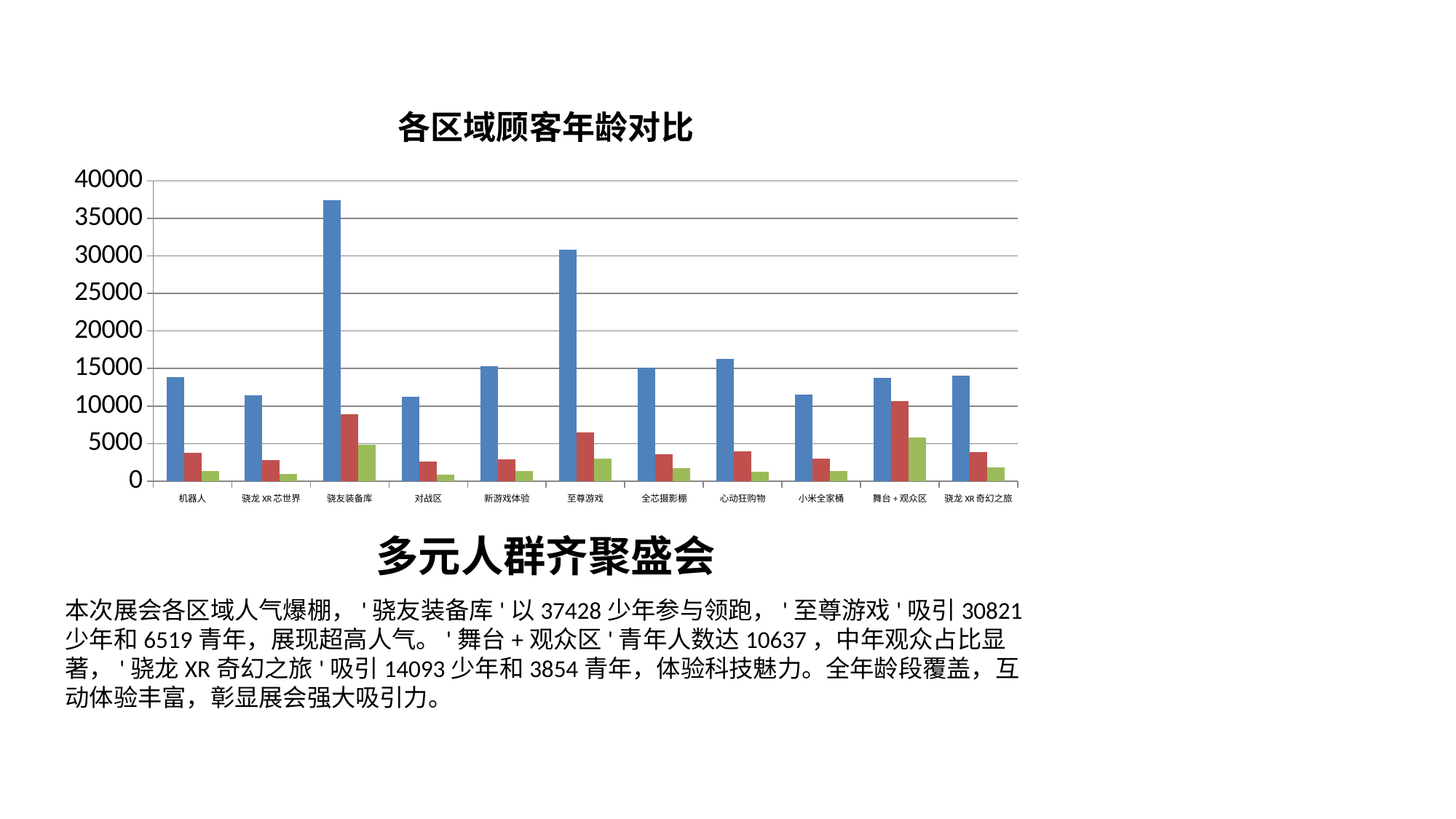
Is the blue bar for 至尊游戏 greater or less than 30000? greater Which has the larger blue bar, 心动狂购物 or 机器人? 心动狂购物 Which has the larger blue bar, 骁友装备库 or 至尊游戏? 骁友装备库 Which category has the tallest red bar in the chart? 舞台＋观众区 Is the blue bar for 机器人 greater or less than 15000? less How many categories (regions) are shown on the x axis of the chart? 11 Is the red bar for 舞台＋观众区 greater or less than 10000? greater Which category has the tallest blue bar in the chart? 骁友装备库 What kind of chart is shown on the slide? bar chart What is the title of the chart? 各区域顾客年龄对比 Which category has the tallest green bar in the chart? 舞台＋观众区